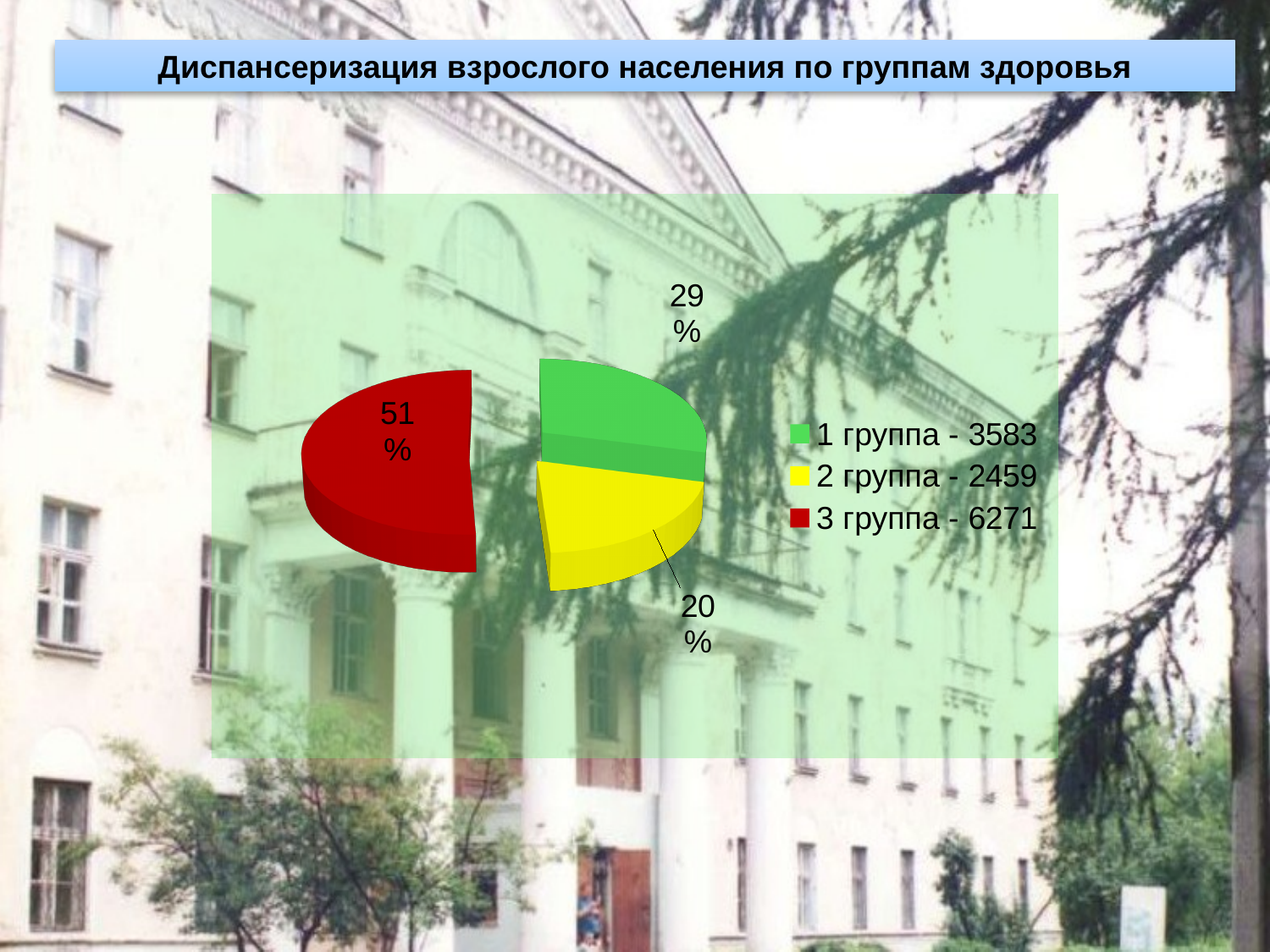
What kind of chart is shown on the slide? pie chart What share of the pie does 2 группа take? 20% What colour is the slice for 2 группа? yellow Which group has the largest slice of the pie? 3 группа What share of the pie does 3 группа take? 51% What value does the legend give for 2 группа? 2459 What is the difference between the values for 3 группа and 1 группа? 2688 How many slices does the pie chart have? 3 What value does the legend give for 3 группа? 6271 What value does the legend give for 1 группа? 3583 Which group has the smallest slice of the pie? 2 группа What share of the pie does 1 группа take? 29%